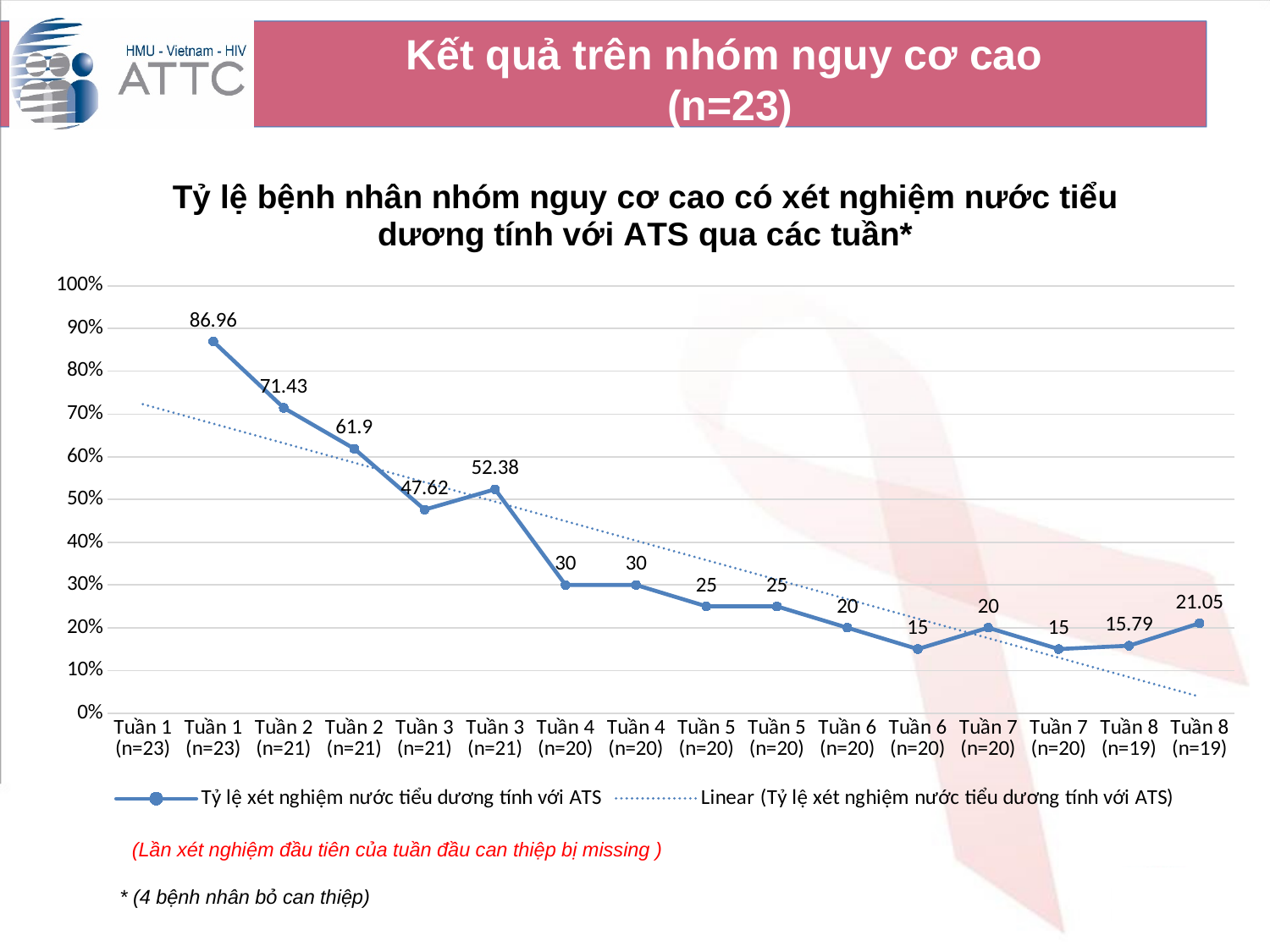
What is the value plotted at the second Tuần 3 (n=21) point? 52.38 What is the lowest value plotted on the line? 15 How many entries does the legend list? 2 Overall, do the values rise or fall from Tuần 1 to Tuần 8? fall What kind of chart is shown on the slide? line chart What is the value plotted at the first Tuần 2 (n=21) point? 71.43 What does the dotted line in the chart represent, according to the legend? Linear (Tỷ lệ xét nghiệm nước tiểu dương tính với ATS) What is the value plotted at the last point, Tuần 8 (n=19)? 21.05 What is the difference between the value at the second Tuần 1 point (86.96) and the first Tuần 2 point (71.43)? 15.53 Which is larger: the value at the first Tuần 3 point or the second Tuần 3 point? second Tuần 3 (52.38) What is the highest value plotted on the line? 86.96 How many data points have value labels on the solid line? 15